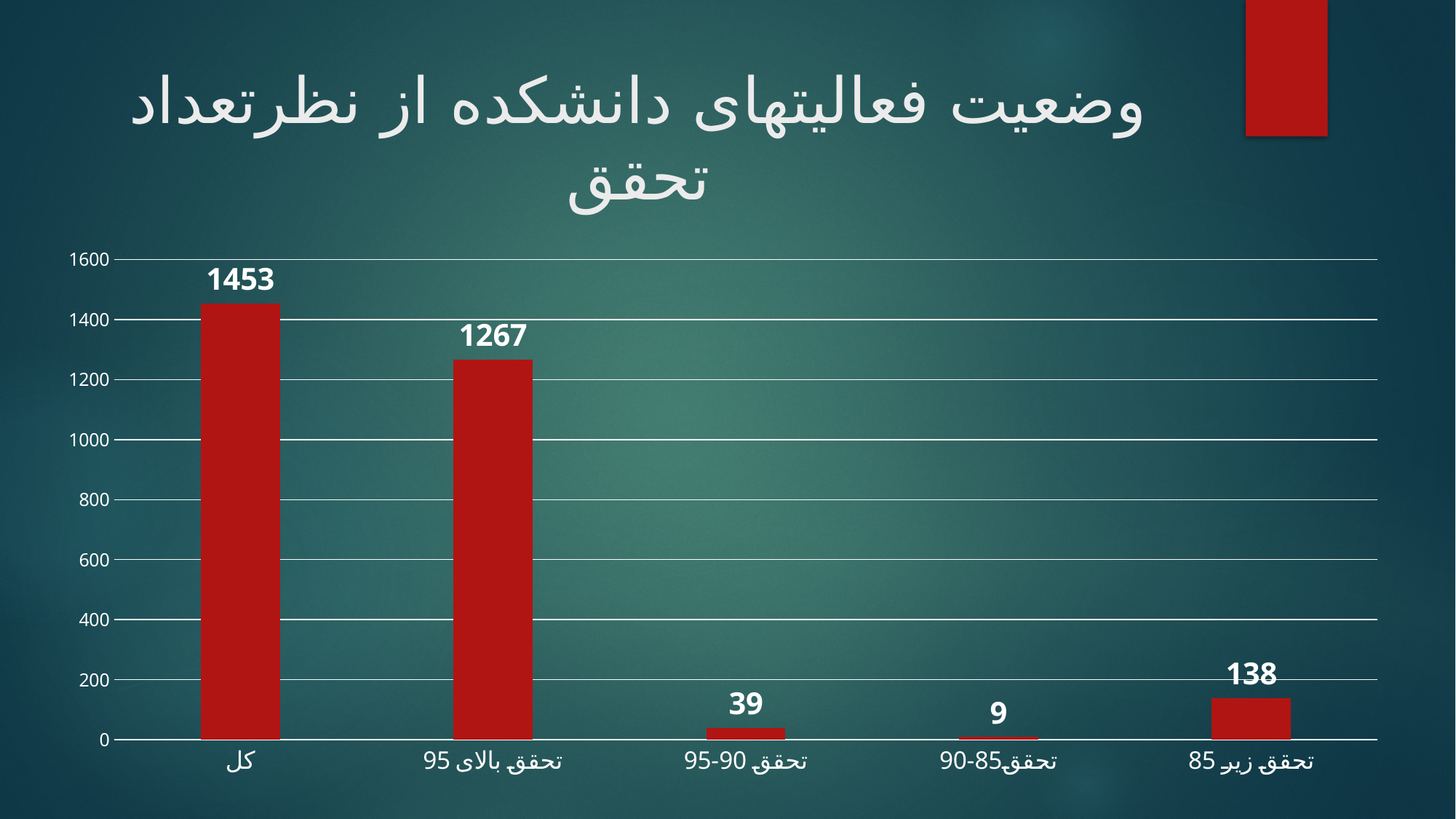
What is the value for تحقق 90-95? 39 Which category has the lowest value? تحقق85-90 Which category has the highest value? کل How many categories are shown in the chart? 5 What is the value for تحقق بالای 95? 1267 What is the value for تحقق زیر 85? 138 What kind of chart is shown on the slide? bar chart What is the value for کل? 1453 What is the value for تحقق85-90? 9 Which is larger, the value for تحقق زیر 85 or the value for تحقق 90-95? تحقق زیر 85 What is the difference between the values for کل and تحقق بالای 95? 186 What is the title of the slide? وضعیت فعالیتهای دانشکده از نظرتعداد تحقق